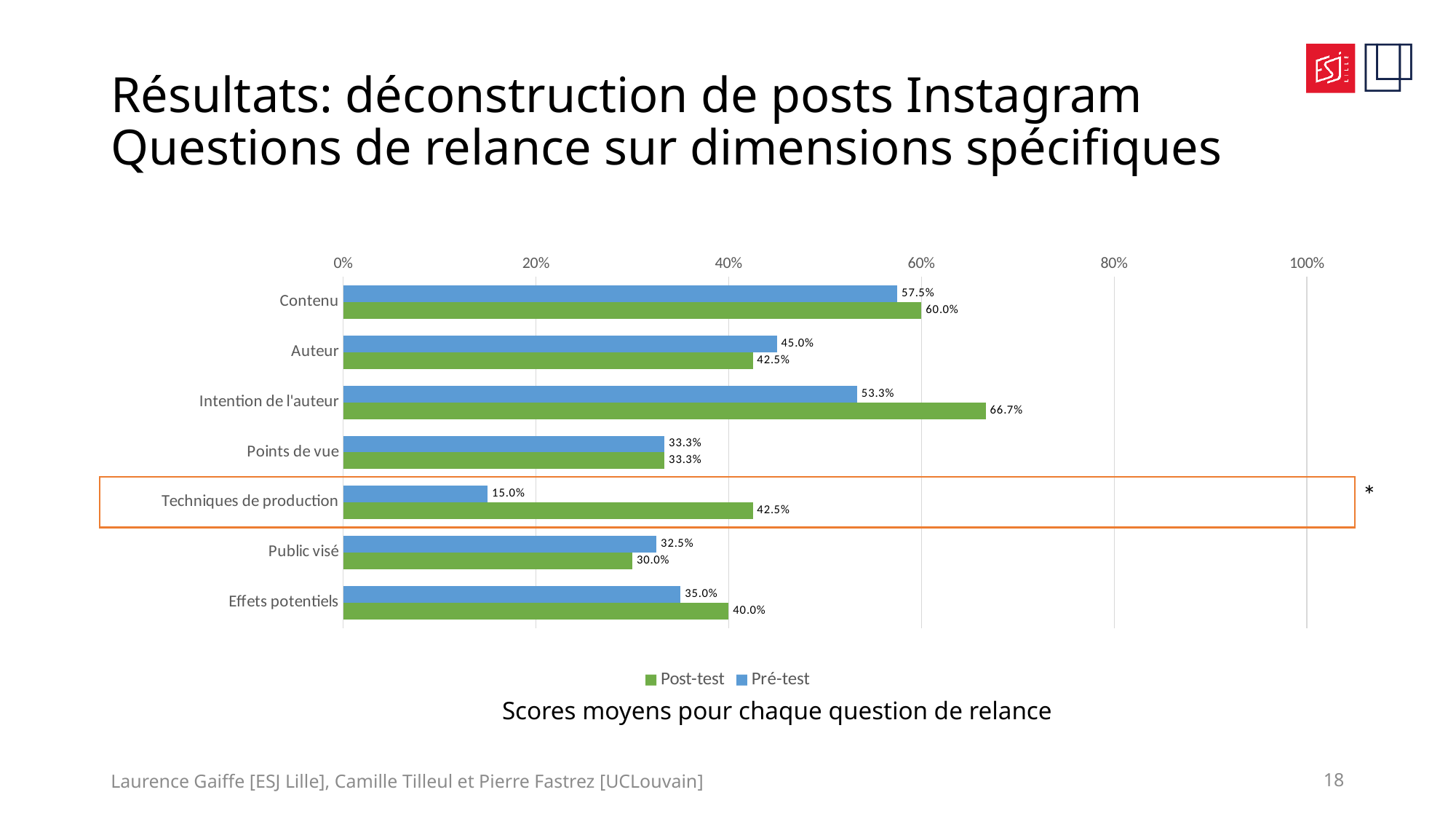
Is the Pré-test value for Contenu greater or less than 40%? greater Which is larger for Auteur, the Pré-test value or the Post-test value? Pré-test What is the Pré-test value for Techniques de production? 15.0% What is the difference between the Post-test and Pré-test values for Techniques de production? 27.5% How many categories are shown on the chart? 7 Which category has the lowest Pré-test value? Techniques de production What kind of chart is shown on the slide? Bar chart What is the Post-test value for Effets potentiels? 40.0% How many series does the legend list? 2 Which category has the highest Post-test value? Intention de l'auteur What is the Post-test value for Intention de l'auteur? 66.7% Which colour represents the Post-test series? Green